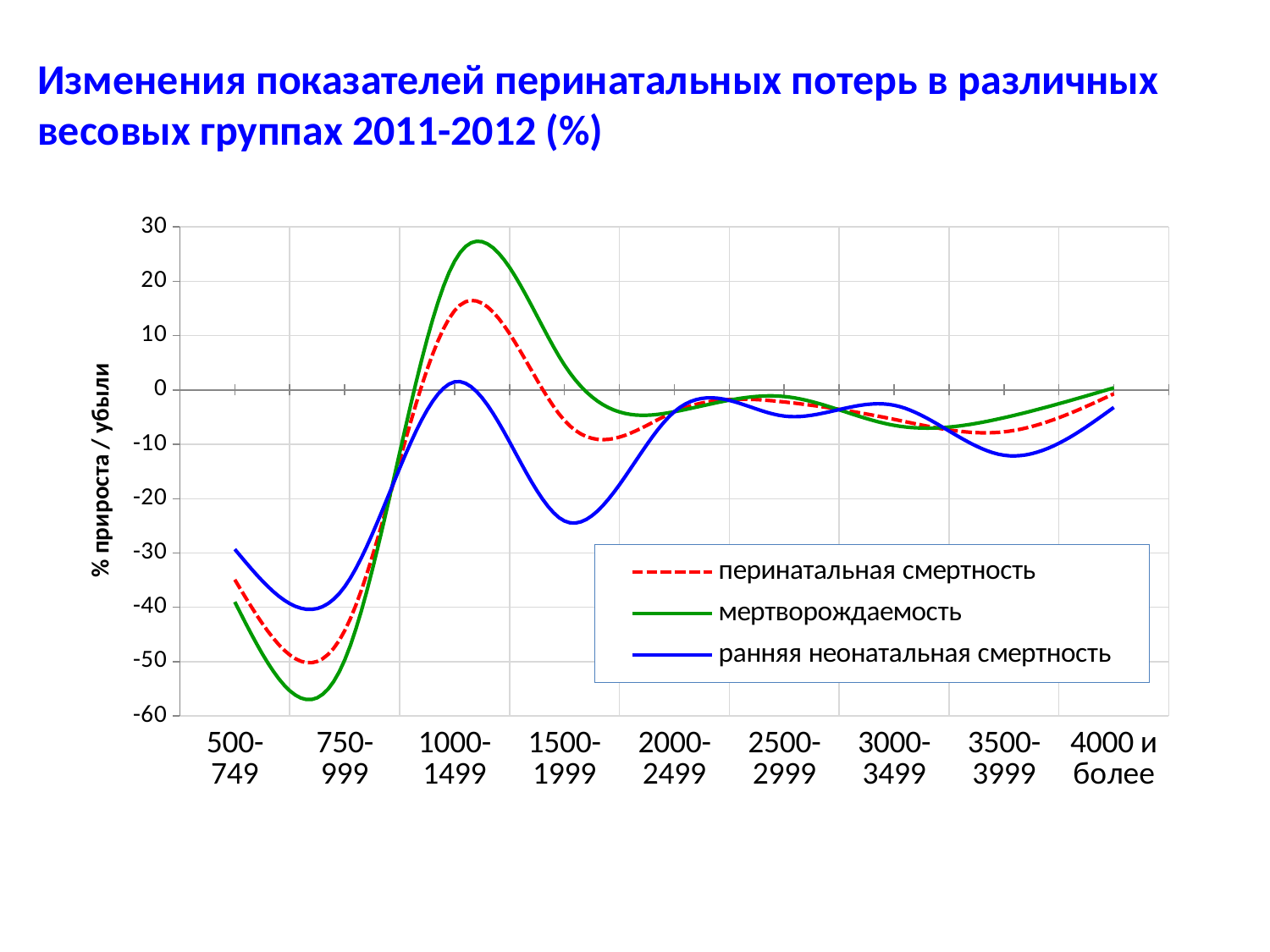
Is the value for перинатальная смертность in the 1000-1499 group greater or less than 10? greater How many weight-group categories are shown on the x axis? 9 Is the value for ранняя неонатальная смертность in the 1500-1999 group greater or less than -20? less Which series is drawn as a dashed red line? перинатальная смертность In the 750-999 group, which is lower: мертворождаемость or ранняя неонатальная смертность? мертворождаемость What is the label of the vertical axis? % прироста / убыли What kind of chart is shown on the slide? line chart How many series does the legend list? 3 In which weight group does мертворождаемость reach its highest value? 1000-1499 In which weight group does мертворождаемость reach its lowest value? 750-999 Is the value for мертворождаемость in the 1000-1499 group greater or less than 20? greater